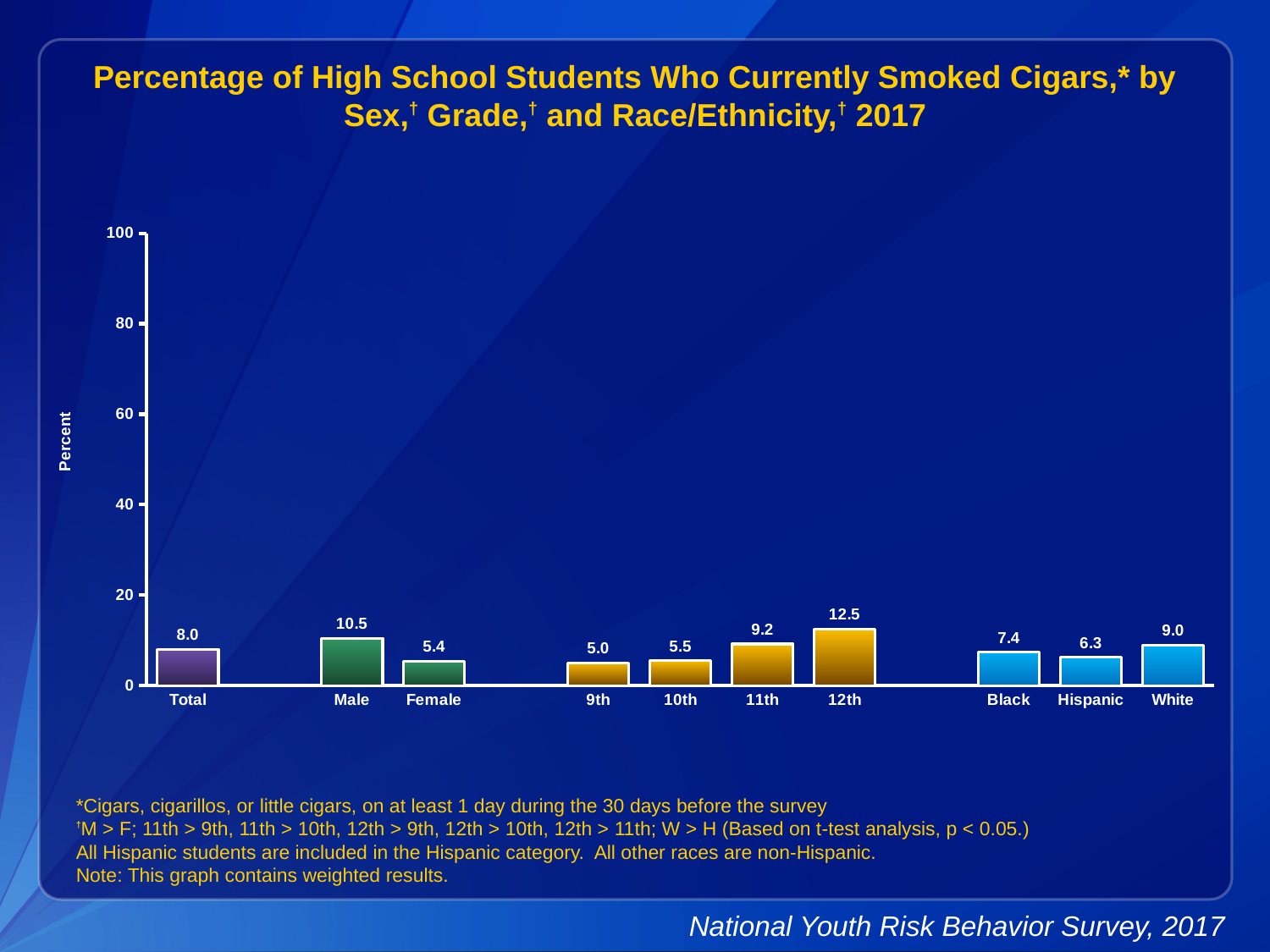
Is the value for 11th grade greater or less than 20? less What is the label on the y axis? Percent What is the value for Total? 8.0 How many categories are shown on the x axis? 10 Which category has the highest value? 12th What is the difference between the Male and Female values? 5.1 What is the value for 12th grade? 12.5 What is the value for Hispanic students? 6.3 Which category has the lowest value? 9th Which is larger, the value for Black or the value for White? White What kind of chart is this? bar chart What percentage of male students currently smoked cigars? 10.5